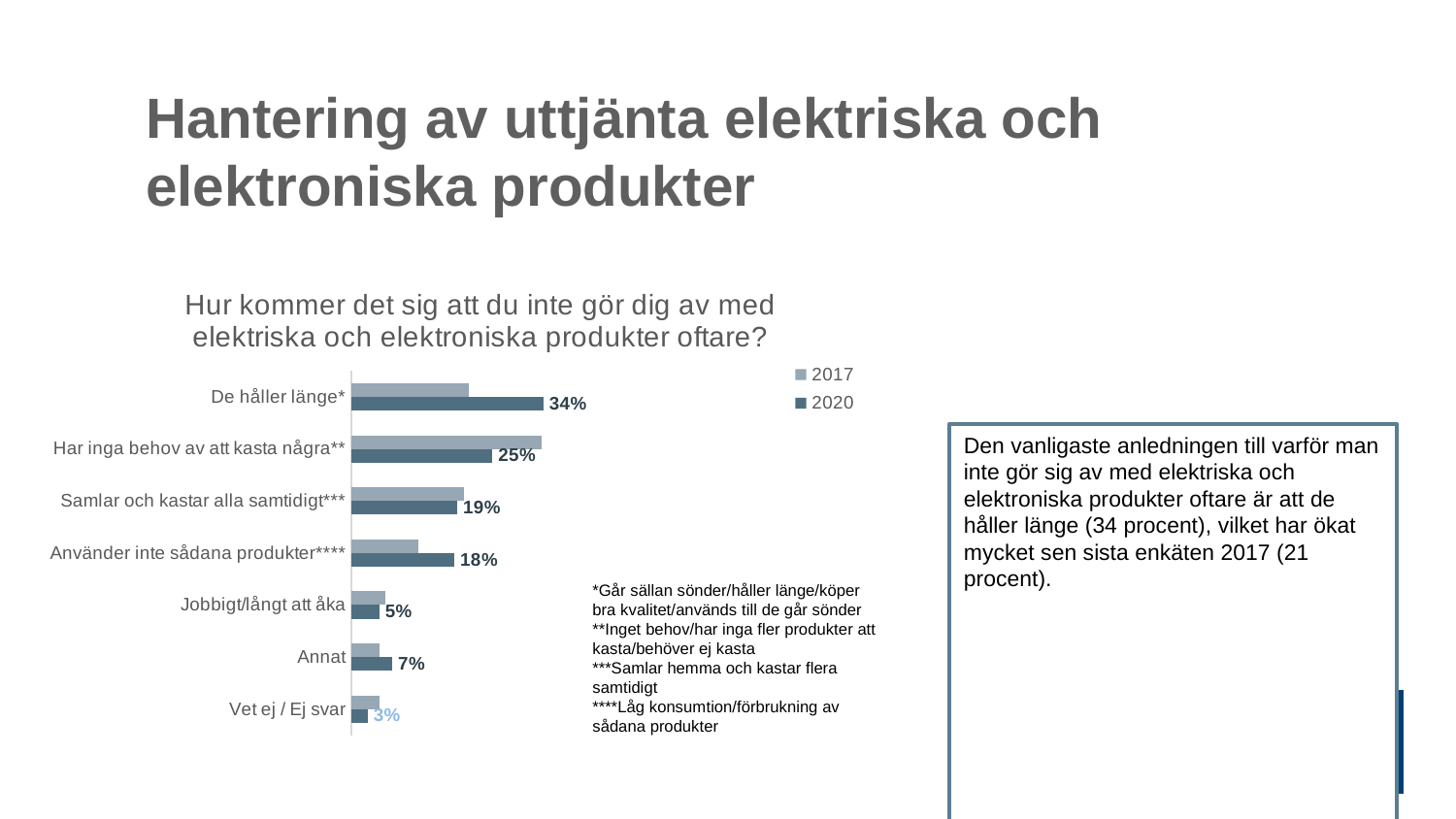
How many series does the legend list? 2 What is the 2020 value for "De håller länge*"? 34% Which category has the lowest 2020 value? Vet ej / Ej svar For "De håller länge*", which series has the larger value, 2017 or 2020? 2020 What is the 2020 value for "Annat"? 7% What is the 2020 value for "Samlar och kastar alla samtidigt***"? 19% What is the difference between the 2020 values for "De håller länge*" and "Har inga behov av att kasta några**"? 9 percentage points Which category has the highest 2020 value? De håller länge* How many categories are shown in the chart? 7 What is the 2020 value for "Har inga behov av att kasta några**"? 25% What kind of chart is shown on the slide? Bar chart What is the 2020 value for "Använder inte sådana produkter****"? 18%